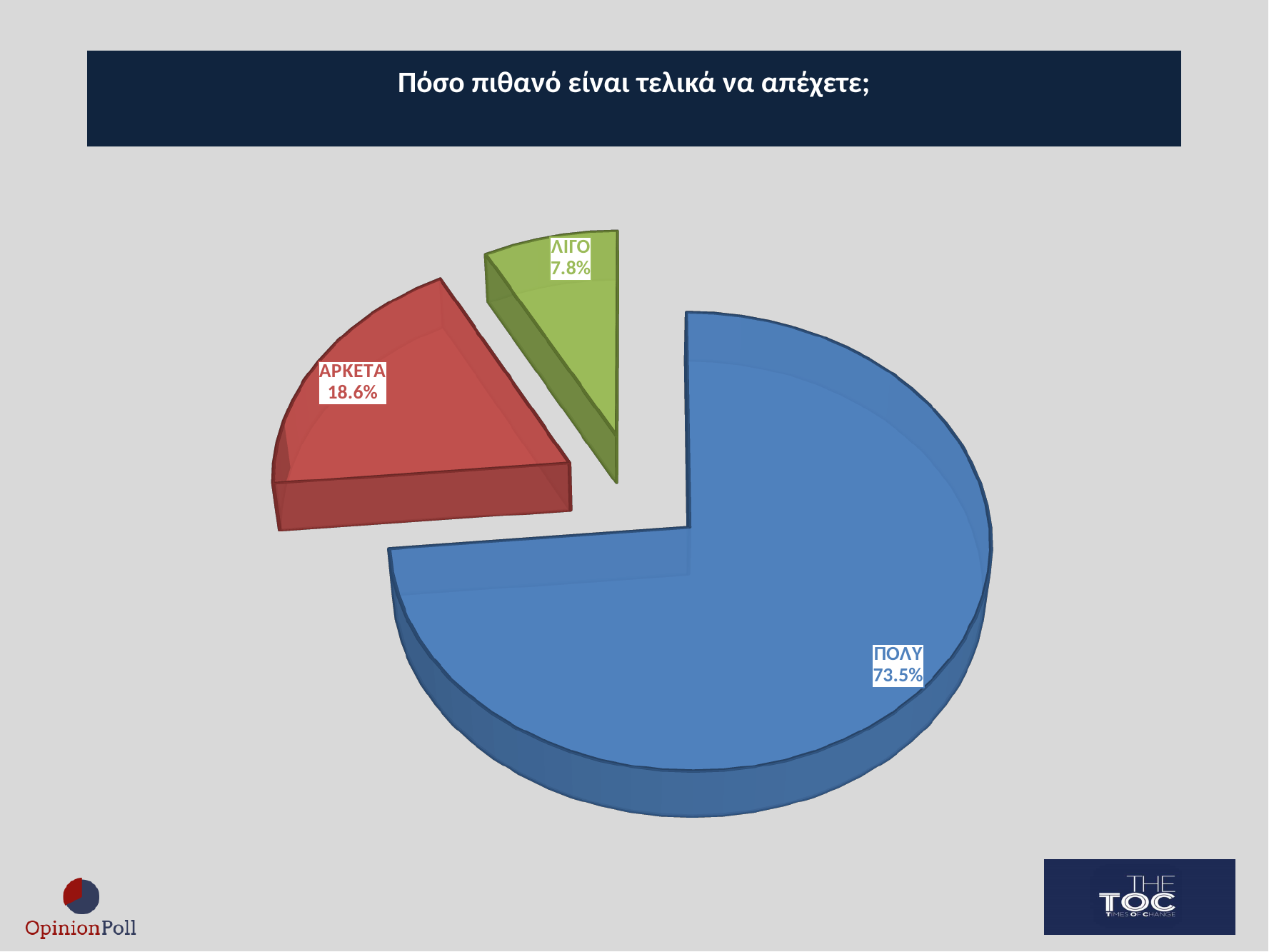
What is the value for ΛΙΓΟ? 7.8% What colour is the ΠΟΛΥ slice? Blue What type of chart is shown on the slide? Pie chart What is the title of the chart? Πόσο πιθανό είναι τελικά να απέχετε; How many slices does the pie chart have? 3 Which category has the smallest share of the pie? ΛΙΓΟ What is the value for ΠΟΛΥ? 73.5% Which is larger, the value for ΑΡΚΕΤΑ or the value for ΛΙΓΟ? ΑΡΚΕΤΑ Which category has the largest share of the pie? ΠΟΛΥ What is the value for ΑΡΚΕΤΑ? 18.6% What is the difference between the values for ΠΟΛΥ and ΑΡΚΕΤΑ? 54.9% What is the difference between the values for ΑΡΚΕΤΑ and ΛΙΓΟ? 10.8%